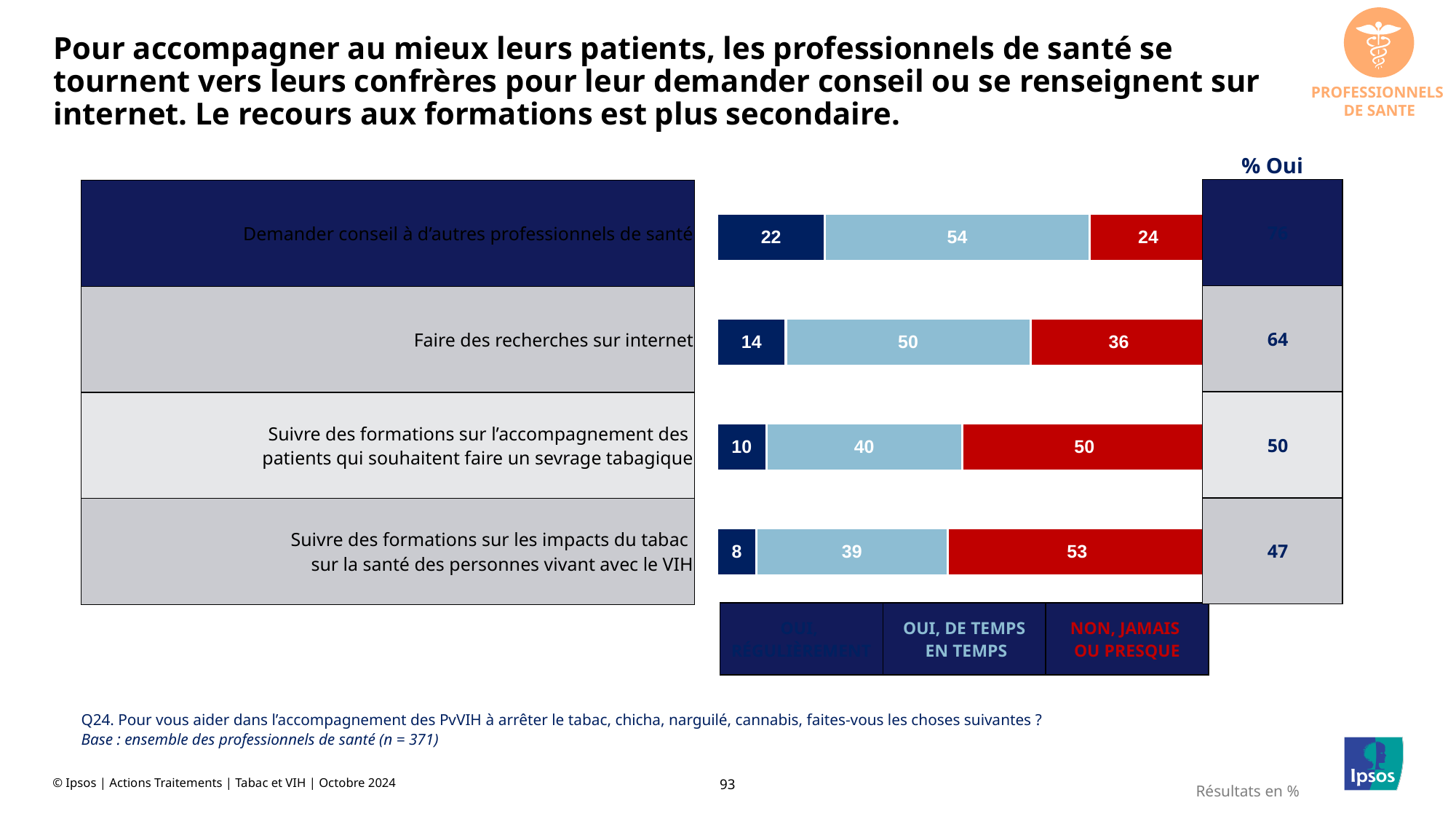
How many series does the legend list? 3 How many categories (rows) are shown in the chart? 4 Which category has the lowest "Oui, de temps en temps" value? Suivre des formations sur les impacts du tabac sur la santé des personnes vivant avec le VIH What is the value of the dark blue (first) segment for "Suivre des formations sur l'accompagnement des patients qui souhaitent faire un sevrage tabagique"? 10 Which has the larger "Oui, de temps en temps" value: "Demander conseil à d'autres professionnels de santé" or "Faire des recherches sur internet"? Demander conseil à d'autres professionnels de santé What is the "% Oui" value shown for "Faire des recherches sur internet"? 64 What is the value of the "Non, jamais ou presque" segment for "Suivre des formations sur les impacts du tabac sur la santé des personnes vivant avec le VIH"? 53 What is the difference between the "Non, jamais ou presque" values for "Faire des recherches sur internet" and "Demander conseil à d'autres professionnels de santé"? 12 What is the total of the stacked bar for "Faire des recherches sur internet"? 100 Which category has the highest "Non, jamais ou presque" value? Suivre des formations sur les impacts du tabac sur la santé des personnes vivant avec le VIH What kind of chart is shown on the slide? Stacked bar chart What is the value of the "Oui, de temps en temps" segment for "Demander conseil à d'autres professionnels de santé"? 54